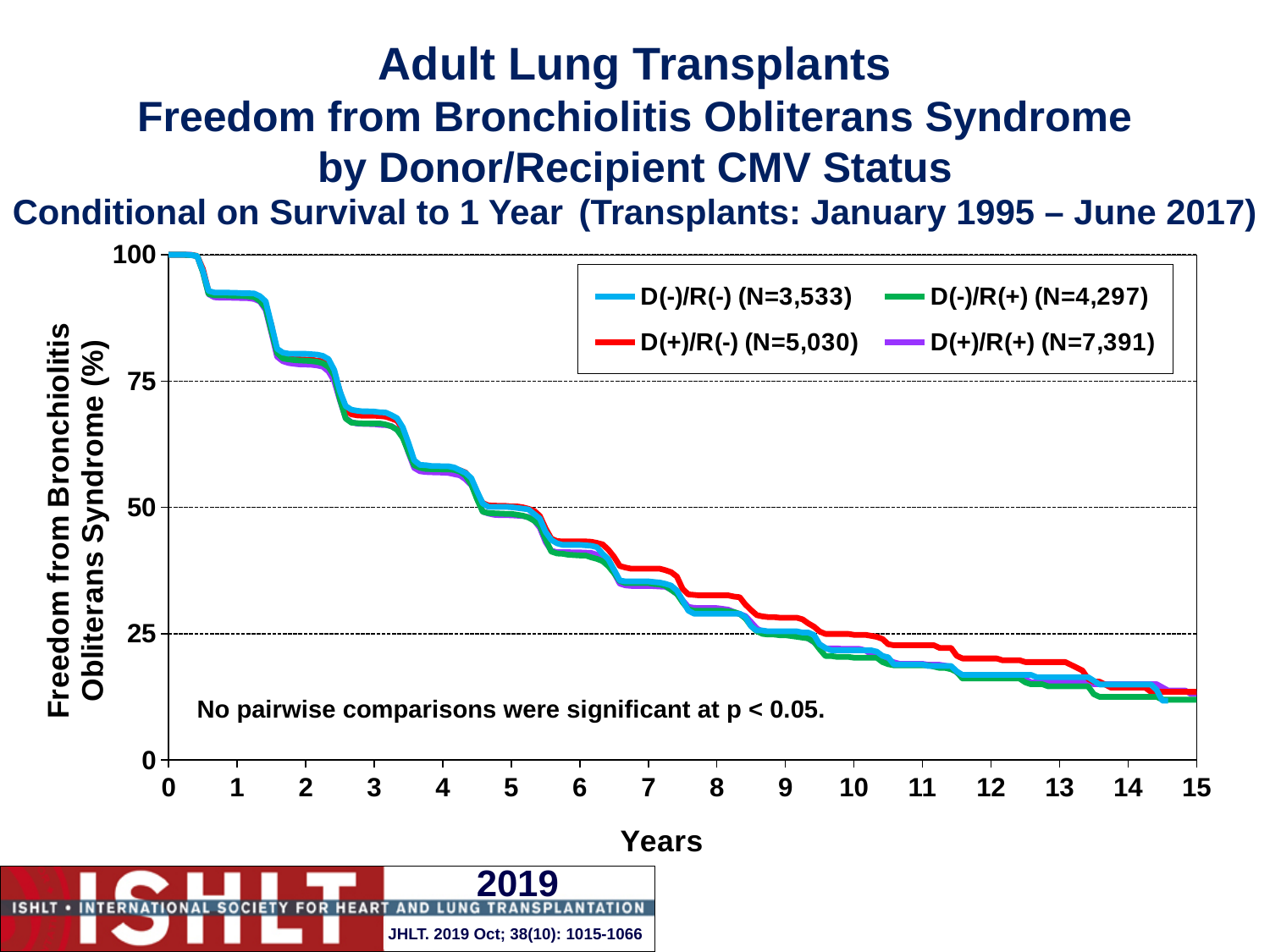
Which group has the smallest N in the legend? D(-)/R(-) Is the freedom from bronchiolitis obliterans syndrome for the D(-)/R(+) group at 12 years greater or less than 25? less How many series does the legend list? 4 Do the curves rise or fall as the number of years increases? fall What colour is the line for the D(+)/R(-) group? red What is the difference between the N for D(+)/R(+) and the N for D(-)/R(-)? 3,858 Which group has the largest N in the legend? D(+)/R(+) What is the N for the D(-)/R(-) group shown in the legend? N=3,533 Is the freedom from bronchiolitis obliterans syndrome for the D(+)/R(-) group at 3 years greater or less than 75? less What is the N for the D(+)/R(+) group shown in the legend? N=7,391 Which group has a larger N, D(+)/R(-) or D(-)/R(+)? D(+)/R(-) What kind of chart is shown on the slide? line chart